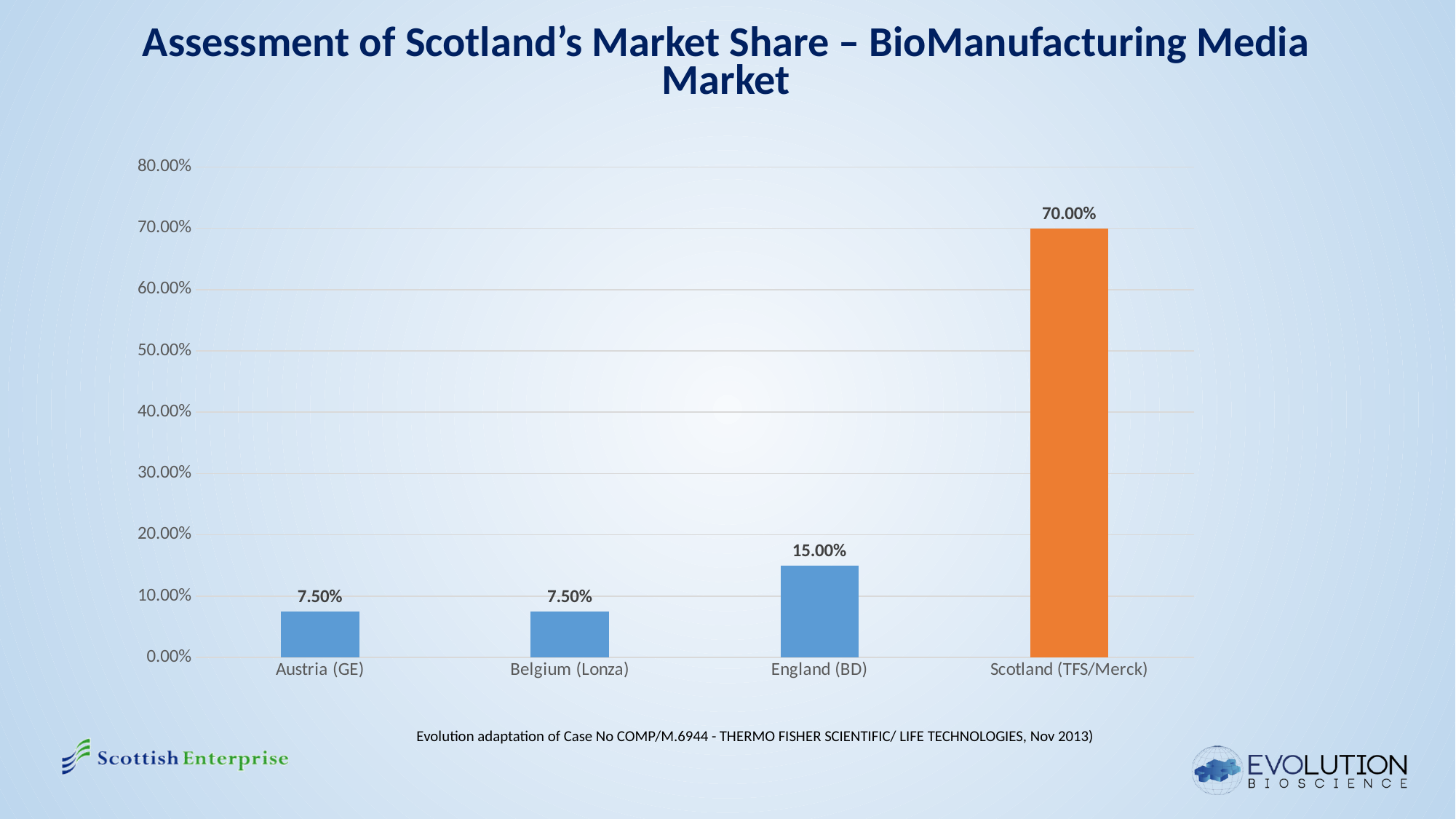
Is the value for Scotland (TFS/Merck) greater or less than 60.00%? greater What is the market share value shown for Austria (GE)? 7.50% What is the difference between the market share of England (BD) and Austria (GE)? 7.50% Which is larger, the market share of England (BD) or Belgium (Lonza)? England (BD) What kind of chart is shown on the slide? Bar chart What is the market share value shown for Belgium (Lonza)? 7.50% Which category has the highest market share? Scotland (TFS/Merck) How many categories are shown on the x axis of the chart? 4 What is the market share value shown for Scotland (TFS/Merck)? 70.00% What colour is the bar for Scotland (TFS/Merck)? Orange What is the difference between the market share of Scotland (TFS/Merck) and England (BD)? 55.00% What is the market share value shown for England (BD)? 15.00%